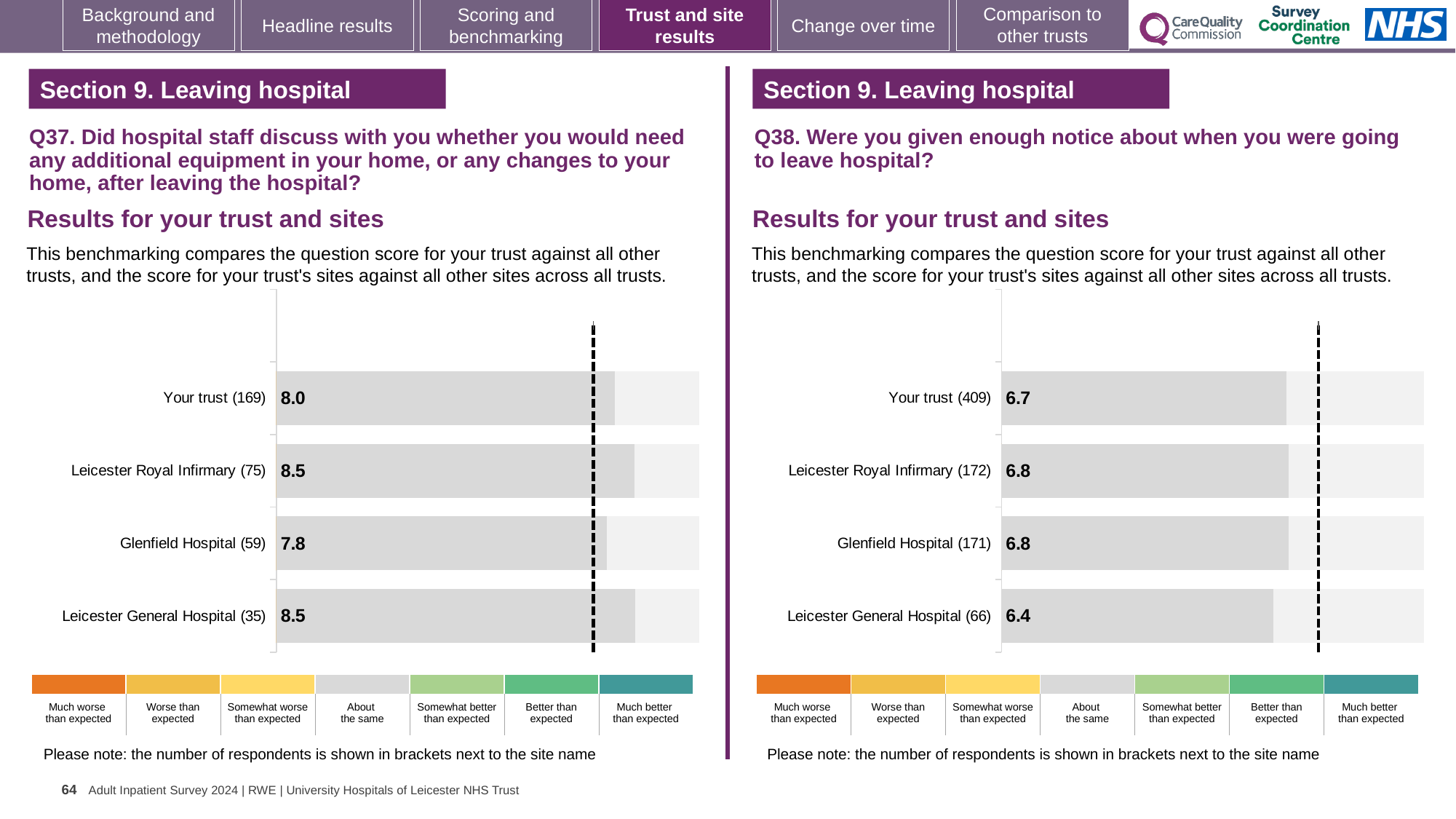
How many categories does the colour legend below the Q37 chart on the left list? 7 In the Q38 chart on the right, what is the score for Leicester General Hospital? 6.4 In the Q37 chart on the left, which site has the lowest score? Glenfield Hospital What kind of chart is the Q38 chart on the right? Bar chart In the Q38 chart on the right, what is the score for Your trust? 6.7 In the Q37 chart on the left, what is the score for Glenfield Hospital? 7.8 How many bars are plotted in the Q37 chart on the left? 4 In the Q38 chart on the right, what is the difference between the scores for Leicester Royal Infirmary and Leicester General Hospital? 0.4 In the Q37 chart on the left, what is the score for Your trust? 8.0 In the Q37 chart on the left, what is the difference between the scores for Leicester Royal Infirmary and Glenfield Hospital? 0.7 In the Q37 chart on the left, which has the higher score: Your trust or Glenfield Hospital? Your trust In the Q38 chart on the right, which site has the lowest score? Leicester General Hospital